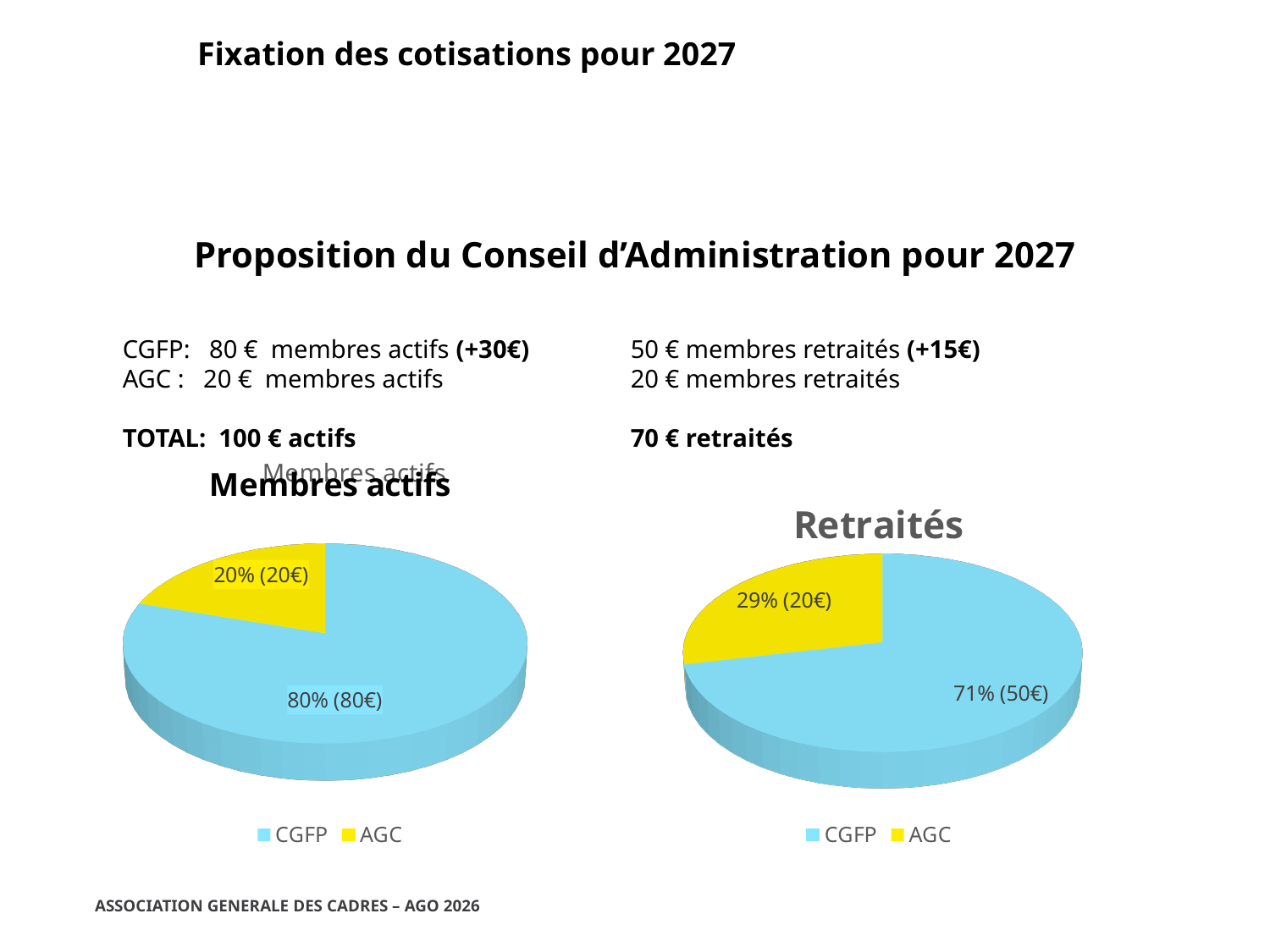
In the 'Retraités' chart, what share of the pie does the CGFP slice represent? 71% In the 'Membres actifs' chart, what is the data label shown for the AGC slice? 20% (20€) In the 'Retraités' chart, what is the data label shown for the AGC slice? 29% (20€) In the 'Membres actifs' chart, which category has the largest slice? CGFP In the 'Retraités' chart, is the CGFP amount larger or smaller than the AGC amount? larger In the 'Membres actifs' chart, what is the difference in euros between the CGFP and AGC amounts? 60€ In the 'Membres actifs' chart, what is the data label shown for the CGFP slice? 80% (80€) In the 'Retraités' chart, what is the data label shown for the CGFP slice? 71% (50€) What type of chart is the 'Membres actifs' chart? Pie chart In the 'Membres actifs' chart, what colour is the AGC slice? Yellow In the 'Retraités' chart, which category has the smallest slice? AGC How many categories does the 'Retraités' chart show? 2